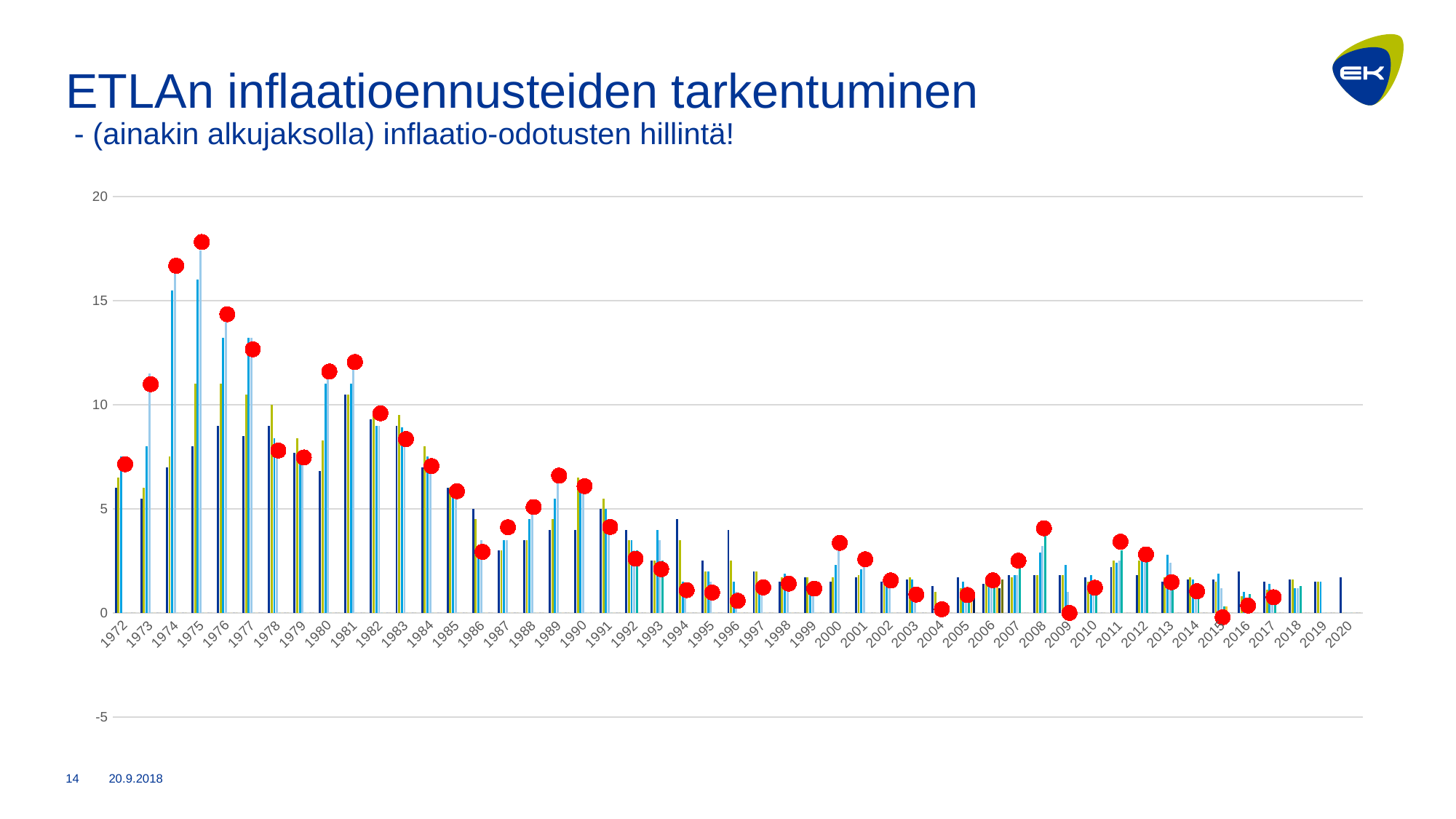
Is the red marker for 2000 greater or less than 5? less Which year has the highest red marker in the chart? 1975 How many years are shown along the x axis of the chart? 49 Do the red markers generally rise or fall from 1975 to 2020? fall What is the title of the chart on the slide? ETLAn inflaatioennusteiden tarkentuminen Which has the larger red marker, 1974 or 1972? 1974 Is the red marker for 1975 greater or less than 15? greater Which has the larger red marker, 1975 or 1990? 1975 What kind of chart is shown on the slide? combination bar and line chart (bars with red markers) Is the red marker for 1972 greater or less than 10? less